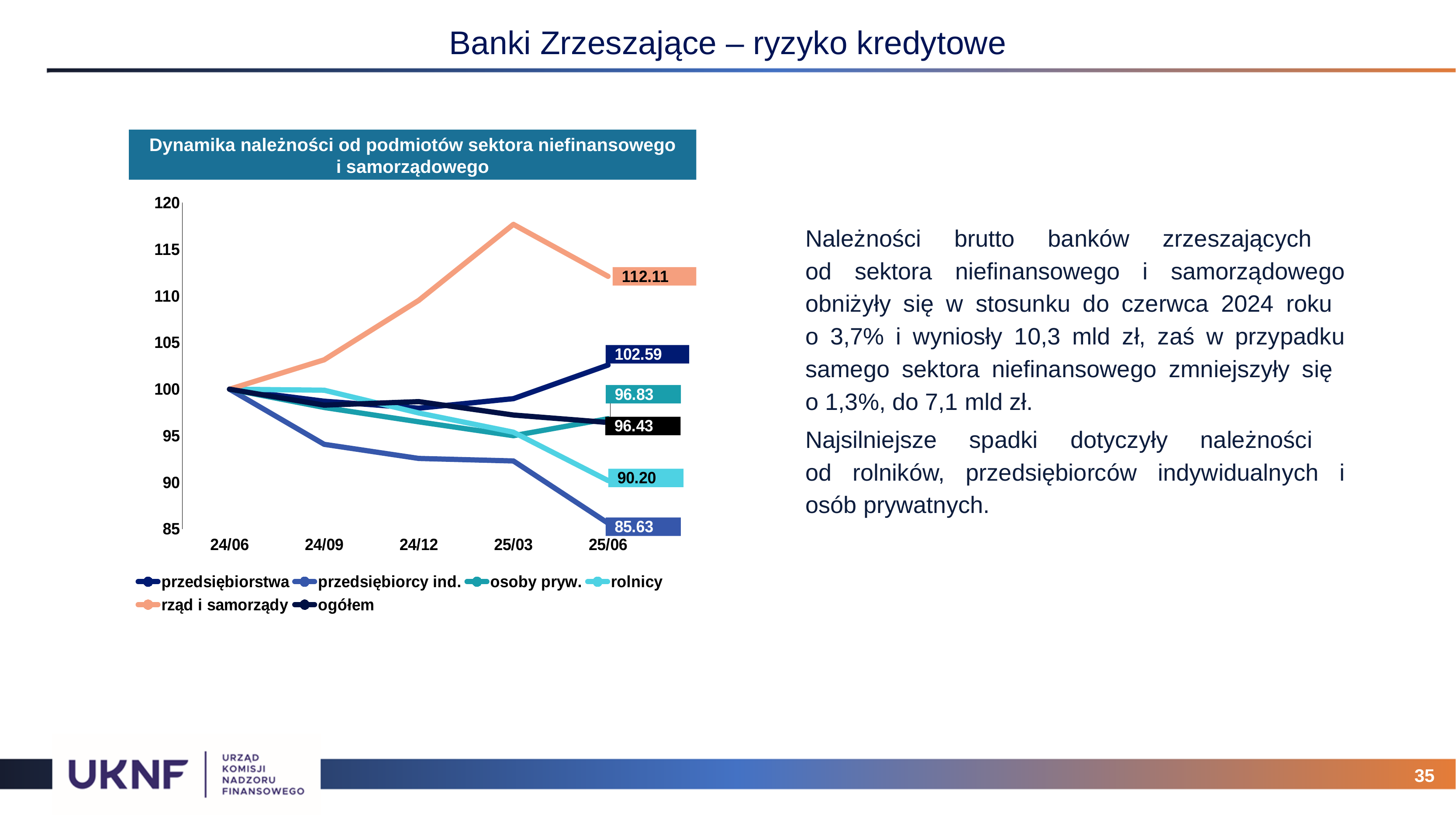
What type of chart is shown on the slide? line chart What is the value for rolnicy at 25/06? 90.20 What is the value for przedsiębiorcy ind. at 25/06? 85.63 At 25/06, which is larger: osoby pryw. or rolnicy? osoby pryw. Is the value for rząd i samorządy at 25/03 greater or less than 115? greater How many series does the legend list? 6 Which series has the highest value at 25/06? rząd i samorządy What is the difference between the 25/06 values for przedsiębiorstwa and przedsiębiorcy ind.? 16.96 Which series has the lowest value at 25/06? przedsiębiorcy ind. What is the value for ogółem at 25/06? 96.43 How many time points are shown on the x axis? 5 What is the value for rząd i samorządy at 25/06? 112.11